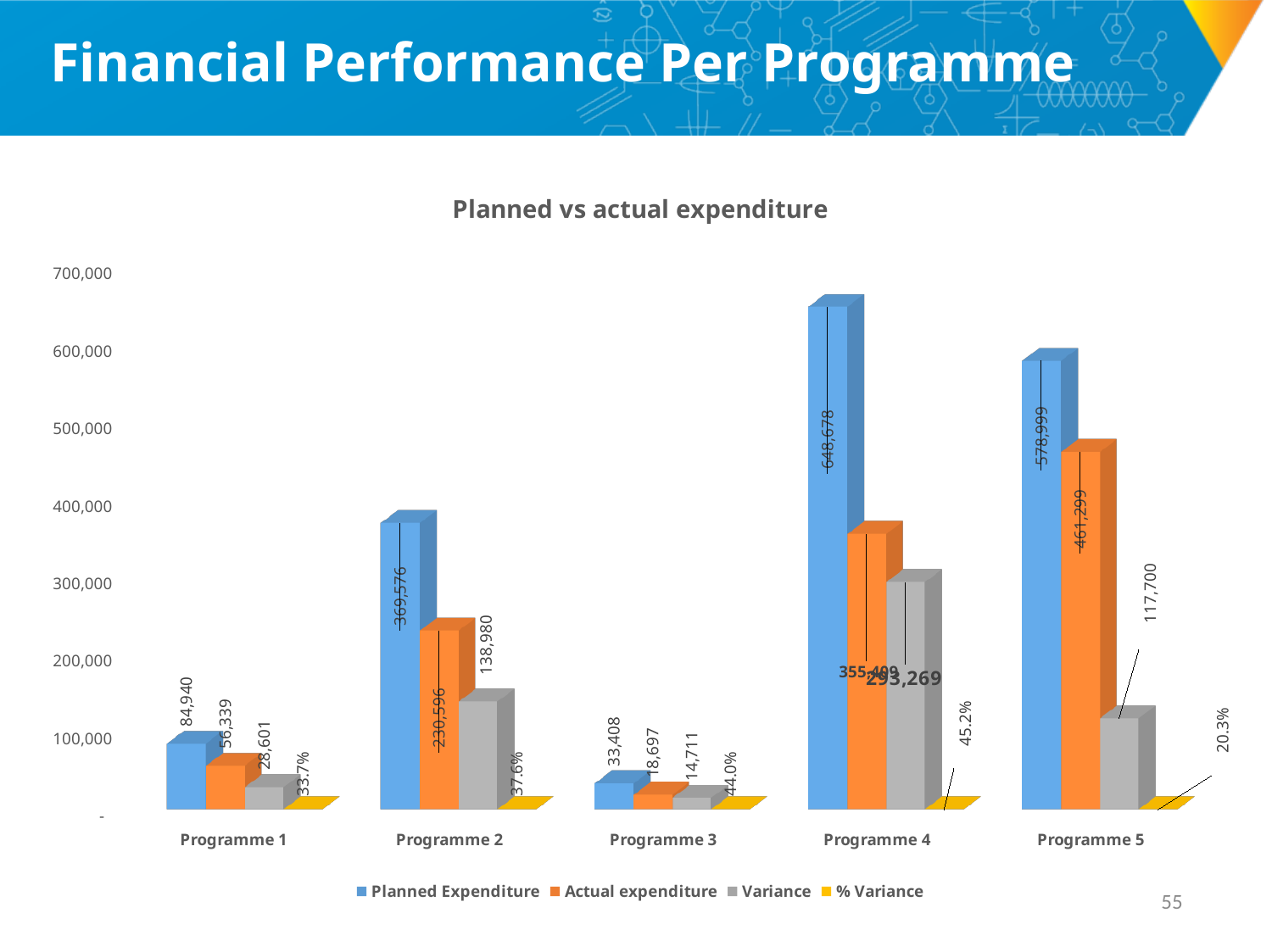
Which programme has the highest Planned Expenditure? Programme 4 What is the Planned Expenditure for Programme 2? 369,576 What is the % Variance for Programme 3? 44.0% What is the Variance for Programme 1? 28,601 Which is larger, the Planned Expenditure for Programme 2 or for Programme 5? Programme 5 What kind of chart is shown on the slide? bar chart Is the Planned Expenditure for Programme 4 greater or less than 600,000? greater How many programmes are shown on the x axis? 5 What is the Actual expenditure for Programme 5? 461,299 What is the difference between Planned Expenditure and Actual expenditure for Programme 2? 138,980 Which programme has the lowest Actual expenditure? Programme 3 How many series does the legend list? 4